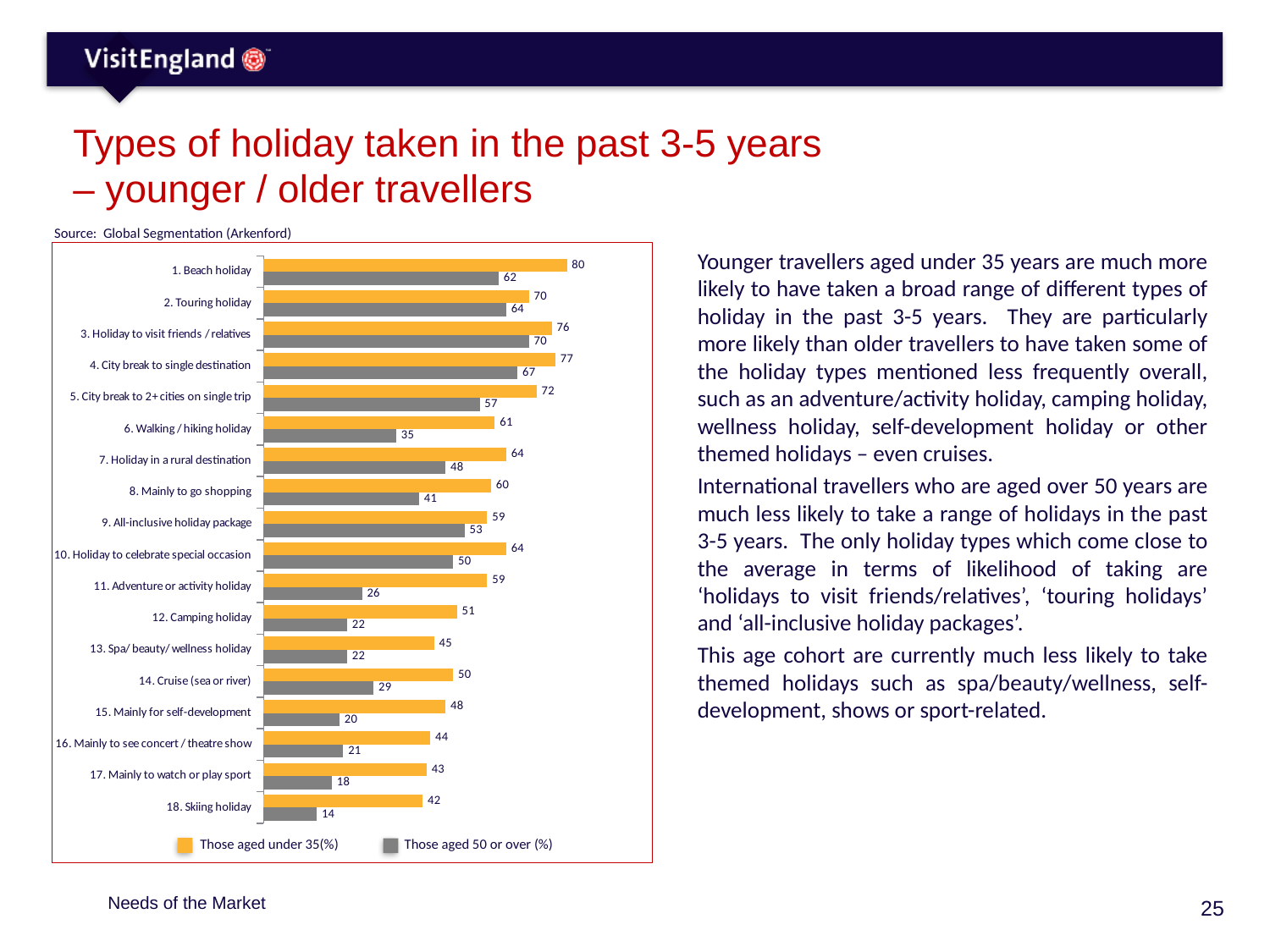
What kind of chart is shown on the slide? Bar chart What is the value for 'Those aged 50 or over (%)' for '18. Skiing holiday'? 14 What is the difference between the under 35 and 50 or over values for '11. Adventure or activity holiday'? 33 Which is larger for '3. Holiday to visit friends / relatives': the value for those aged under 35 or those aged 50 or over? Those aged under 35(%) What is the value for 'Those aged 50 or over (%)' for '6. Walking / hiking holiday'? 35 What is the value for 'Those aged 50 or over (%)' for '14. Cruise (sea or river)'? 29 Which category has the highest value for 'Those aged under 35(%)'? 1. Beach holiday Which category has the lowest value for 'Those aged 50 or over (%)'? 18. Skiing holiday What colour represents 'Those aged under 35(%)' in the chart? Orange How many holiday type categories are shown in the chart? 18 How many series does the legend list? 2 What is the value for 'Those aged under 35(%)' for '1. Beach holiday'? 80